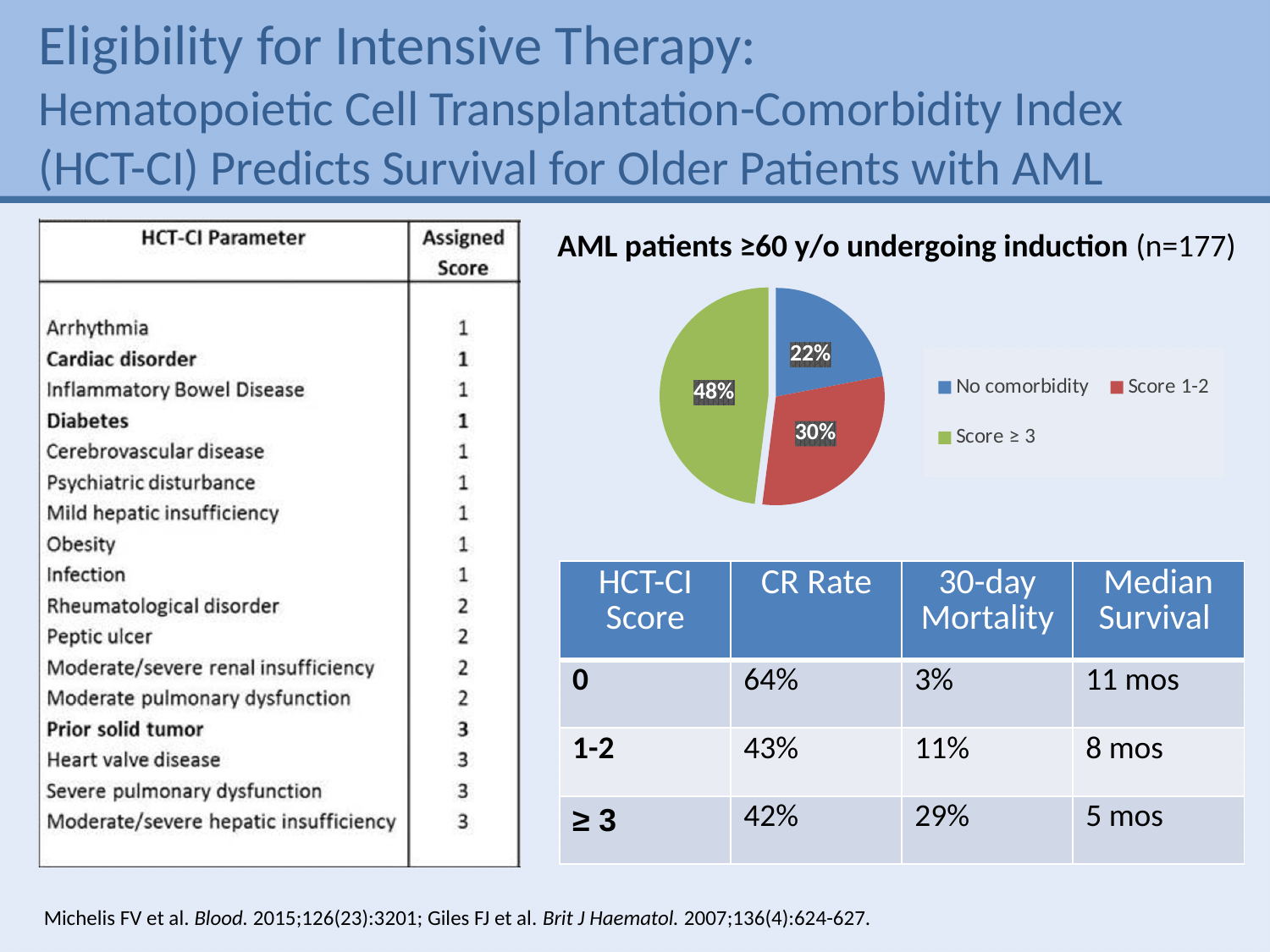
What share of the pie chart is labelled "Score ≥ 3"? 48% What share of the pie chart is labelled "No comorbidity"? 22% Which category has the smallest slice in the pie chart? No comorbidity How many entries does the pie chart legend list? 3 Which slice is larger in the pie chart, "Score 1-2" or "No comorbidity"? Score 1-2 What type of chart is shown on the slide? Pie chart What share of the pie chart is labelled "Score 1-2"? 30% Which category has the largest slice in the pie chart? Score ≥ 3 What is the difference in percentage points between the "Score ≥ 3" slice and the "No comorbidity" slice? 26 How many slices does the pie chart have? 3 What colour is the "Score ≥ 3" slice in the pie chart? Green What is the difference in percentage points between the "Score 1-2" slice and the "No comorbidity" slice? 8